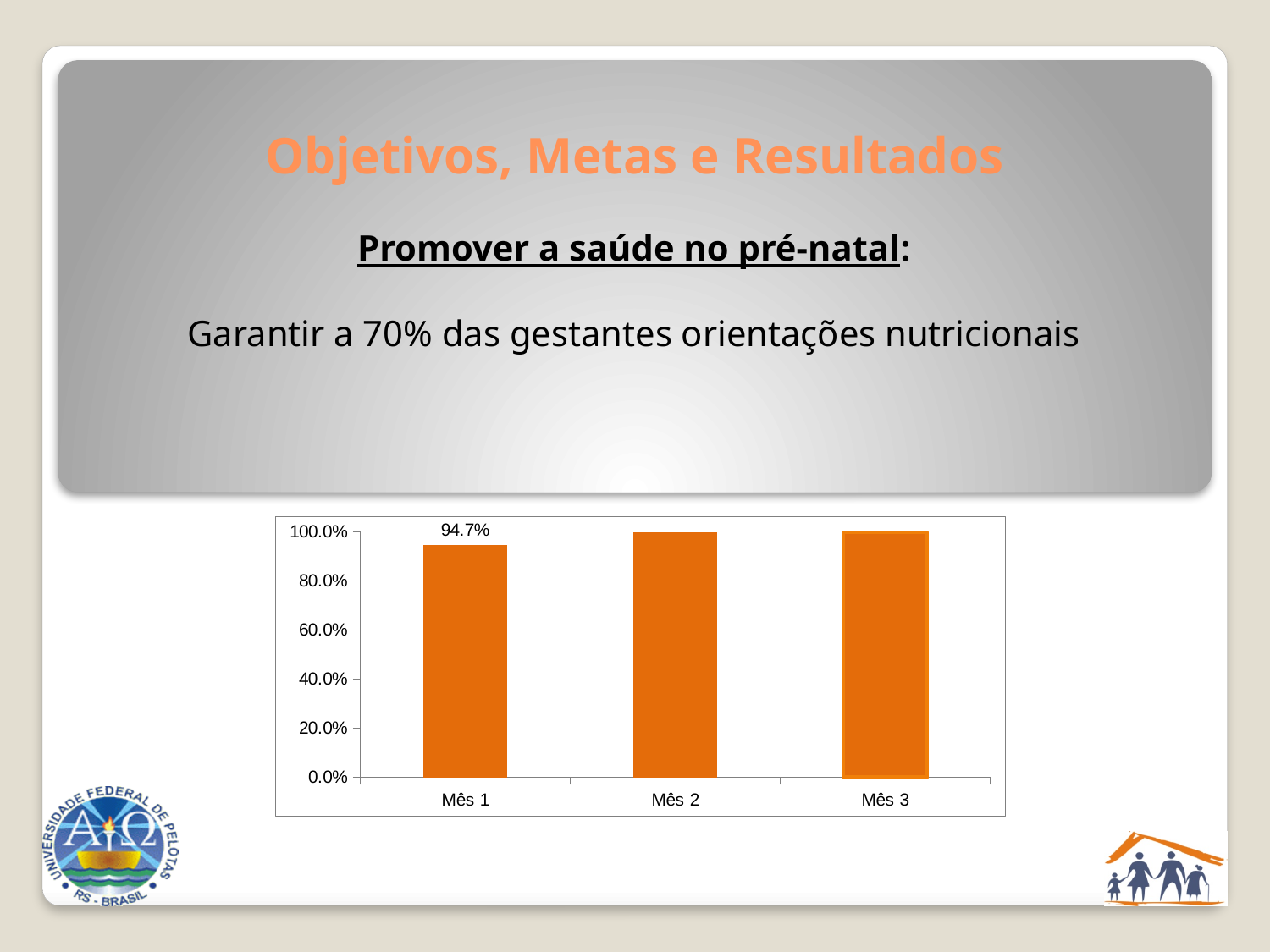
Is the value for Mês 3 greater or less than 60.0%? greater What colour are the bars in the chart? orange How many months are shown on the x axis? 3 Is the value for Mês 1 greater or less than 80.0%? greater What is the difference between the values for Mês 2 and Mês 1? 5.3% Do the values rise or fall from Mês 1 to Mês 2? rise What is the value for Mês 1? 94.7% Which is larger, the value for Mês 1 or the value for Mês 2? Mês 2 Which month has the lowest value? Mês 1 What kind of chart is shown on the slide? bar chart What is the value for Mês 2? 100.0% What is the value for Mês 3? 100.0%